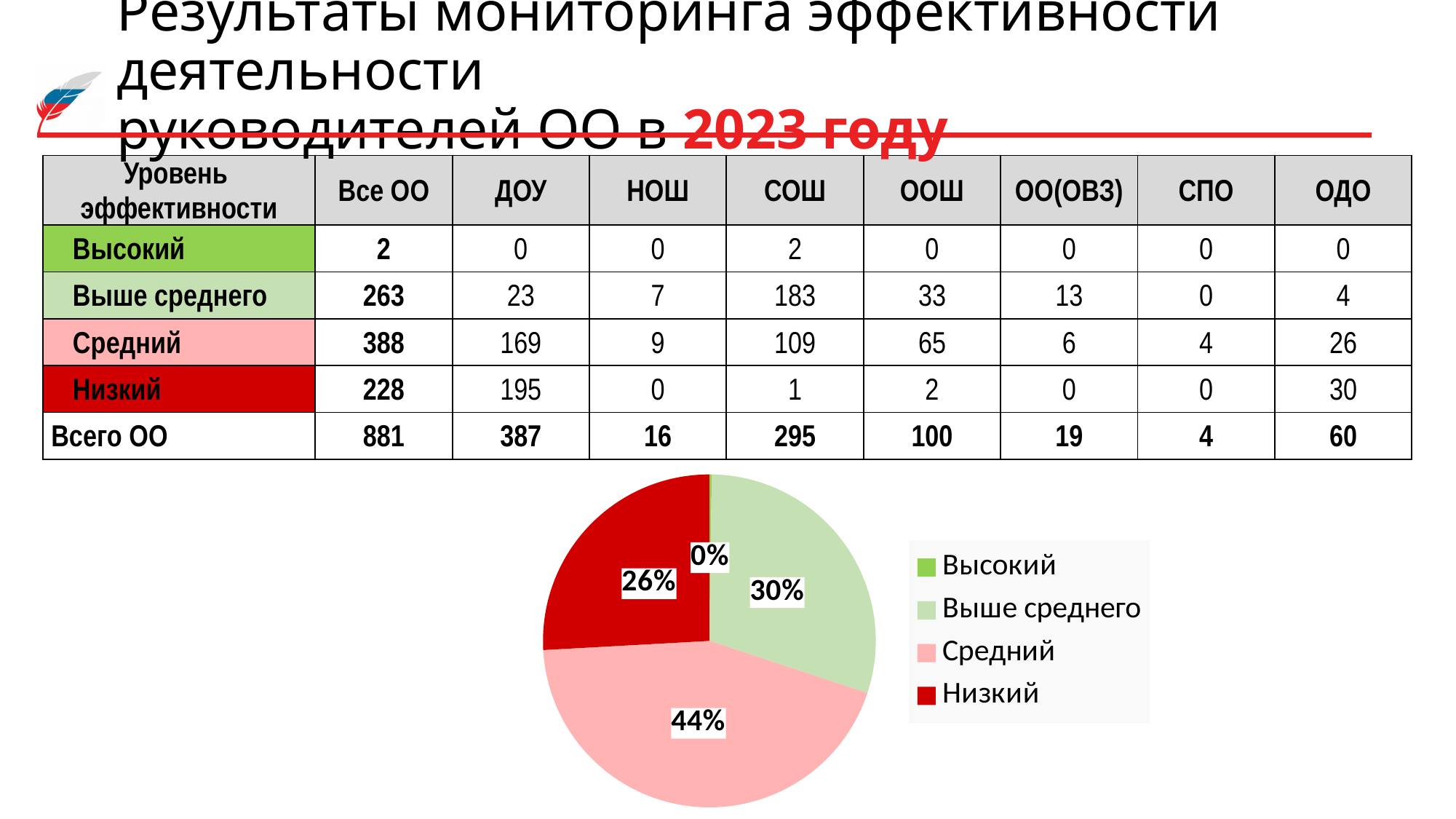
How many entries does the pie chart legend list? 4 What share of the pie chart does the "Средний" slice represent? 44% How many categories are shown in the pie chart? 4 What share of the pie chart does the "Высокий" slice represent? 0% What is the difference in percentage points between the "Средний" and "Низкий" slices in the pie chart? 18% What kind of chart is shown on the slide? pie chart What colour is the "Низкий" slice in the pie chart? red Which category has the smallest slice in the pie chart? Высокий What share of the pie chart does the "Выше среднего" slice represent? 30% In the pie chart, which slice is larger: "Выше среднего" or "Низкий"? Выше среднего Which category has the largest slice in the pie chart? Средний